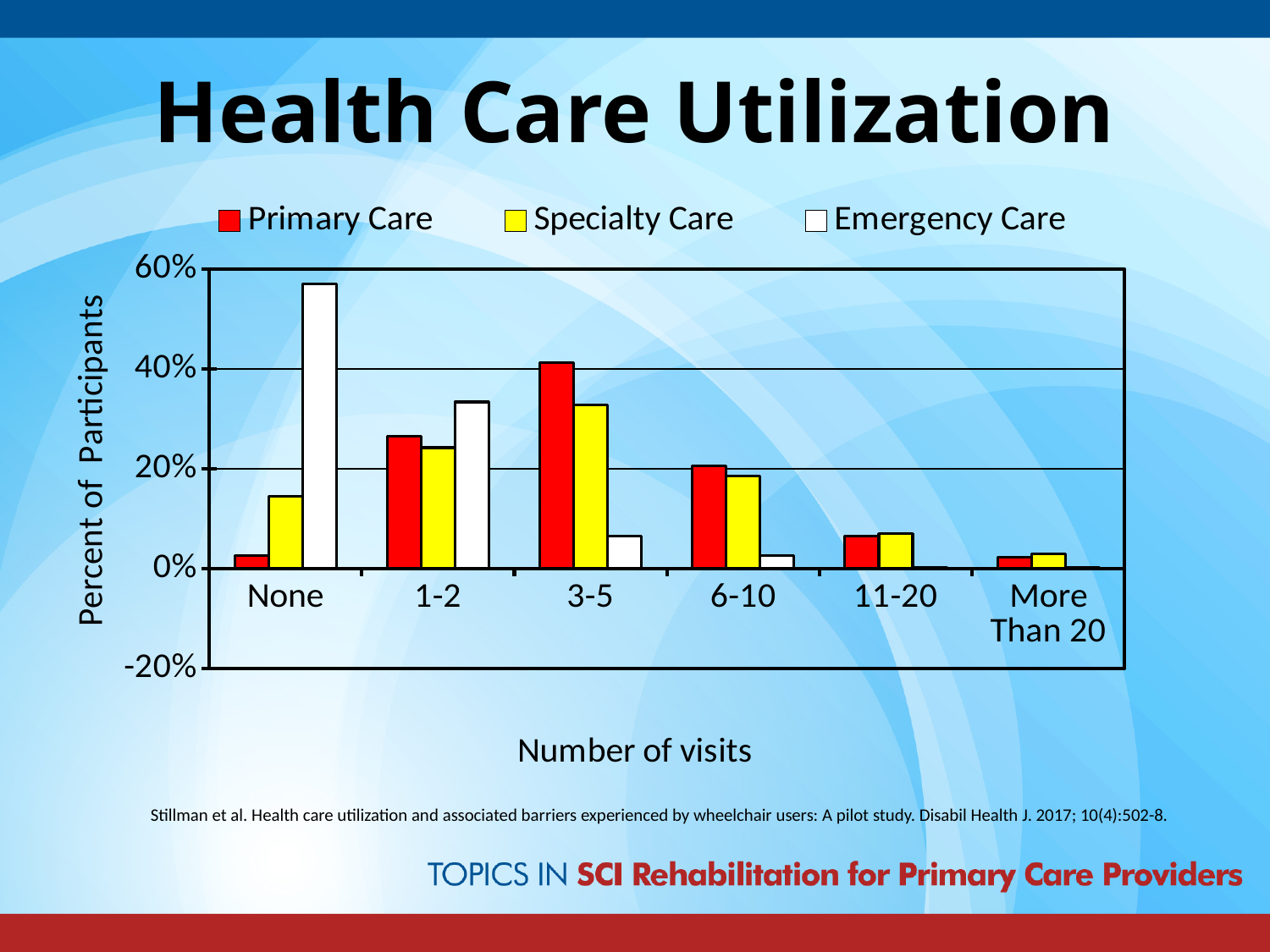
Which number-of-visits category has the highest Emergency Care value? None Is the Specialty Care value for 1-2 greater or less than 40%? less Does the Emergency Care value rise or fall as the number of visits increases from None to More Than 20? fall How many series does the legend list? 3 For the 3-5 category, which is larger: Primary Care or Emergency Care? Primary Care Which number-of-visits category has the highest Primary Care value? 3-5 Is the Emergency Care value for None greater or less than 40%? greater What is the title of the x axis? Number of visits Is the Primary Care value for 3-5 greater or less than 20%? greater What kind of chart is shown on the slide? bar chart How many categories of number of visits are shown on the x axis? 6 For the None category, which is larger: Emergency Care or Primary Care? Emergency Care